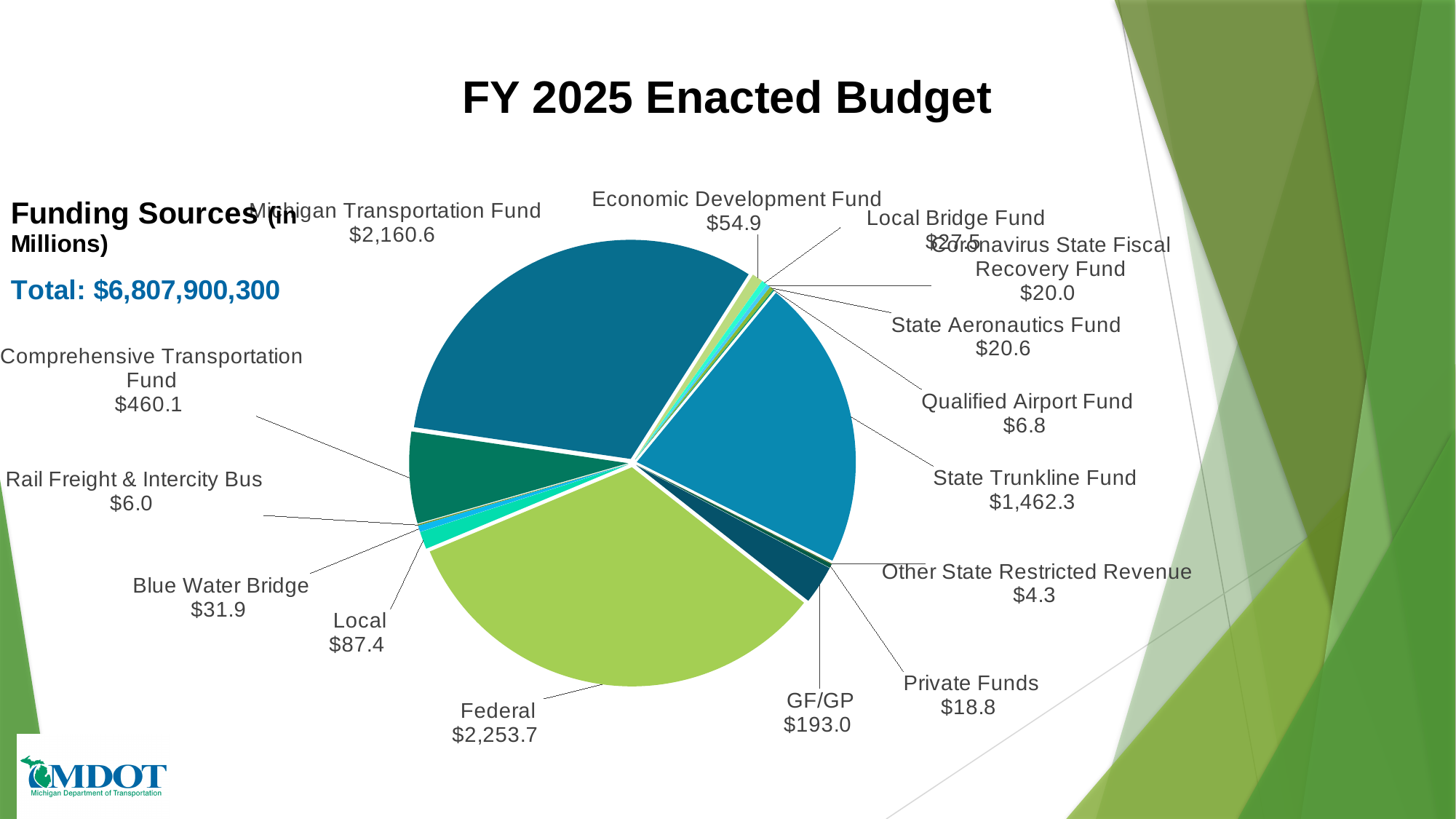
Which funding source is the largest slice of the pie? Federal What is the value for the Comprehensive Transportation Fund? $460.1 What is the difference between the Comprehensive Transportation Fund and GF/GP values? $267.1 What type of chart is shown on the slide? Pie chart Which is larger, the Michigan Transportation Fund or the State Trunkline Fund? Michigan Transportation Fund What is the difference between the Federal value and the Michigan Transportation Fund value? $93.1 How many funding sources are shown in the pie chart? 15 What is the value for the State Trunkline Fund? $1,462.3 Which funding source has the smallest value? Other State Restricted Revenue What is the value for GF/GP? $193.0 What total is stated for the funding sources on the slide? $6,807,900,300 What is the value for Federal funding? $2,253.7